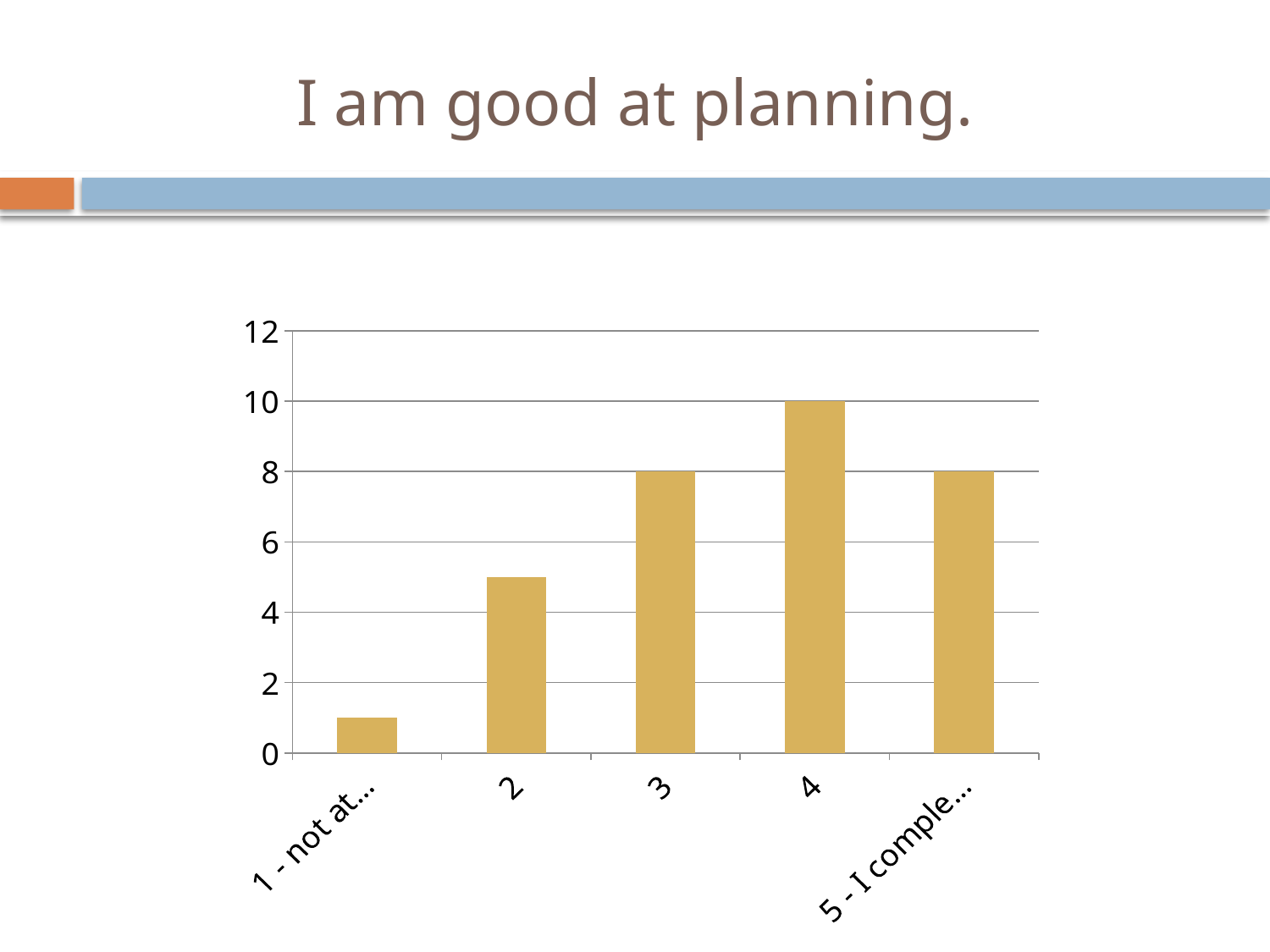
Is the value for the first category (1 - not at...) greater or less than 2? less Which category has the lowest value? 1 - not at... Which is larger, the value for category 2 or the value for category 3? 3 What kind of chart is shown on the slide? bar chart How many categories are shown on the x axis? 5 What is the value for category 4? 10 What is the value for the last category (5 - I comple...)? 8 What is the value for category 3? 8 What is the difference between the values for category 4 and category 3? 2 Which category has the highest value? 4 What is the title of the slide? I am good at planning. Is the value for category 2 greater or less than 4? greater